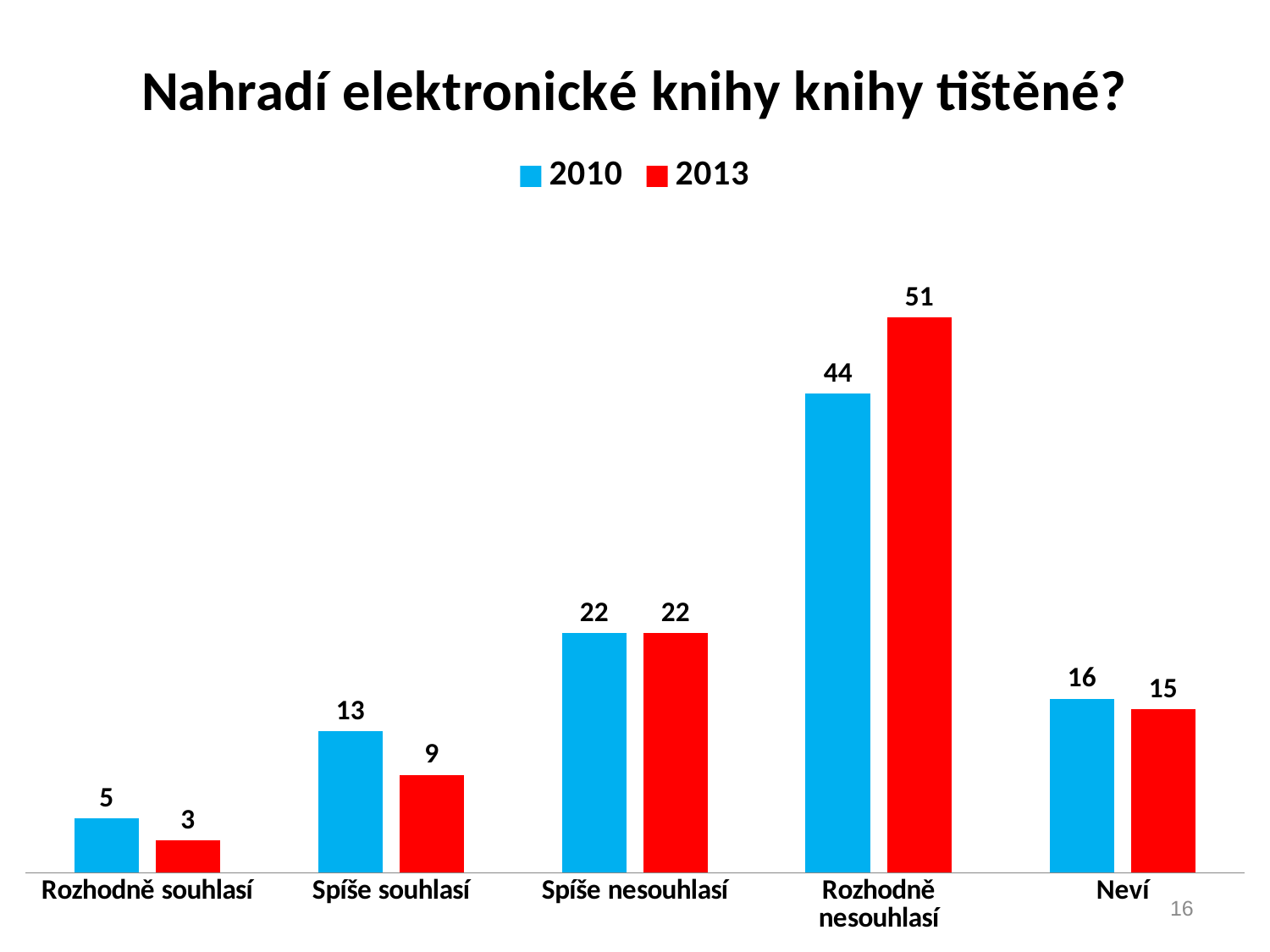
Which category has the lowest value for the 2013 series? Rozhodně souhlasí What is the difference between the 2010 and 2013 values for 'Spíše souhlasí'? 4 What is the title of the chart? Nahradí elektronické knihy knihy tištěné? What is the difference between the 2013 and 2010 values for 'Rozhodně nesouhlasí'? 7 What is the value for 2013 in the 'Neví' category? 15 Which is larger for 'Neví': the 2010 value or the 2013 value? 2010 How many series does the legend list? 2 What kind of chart is shown on the slide? Bar chart What is the value for 2013 in the 'Rozhodně nesouhlasí' category? 51 Which category has the highest value for the 2010 series? Rozhodně nesouhlasí What is the value for 2010 in the 'Spíše souhlasí' category? 13 How many categories are shown on the x axis? 5